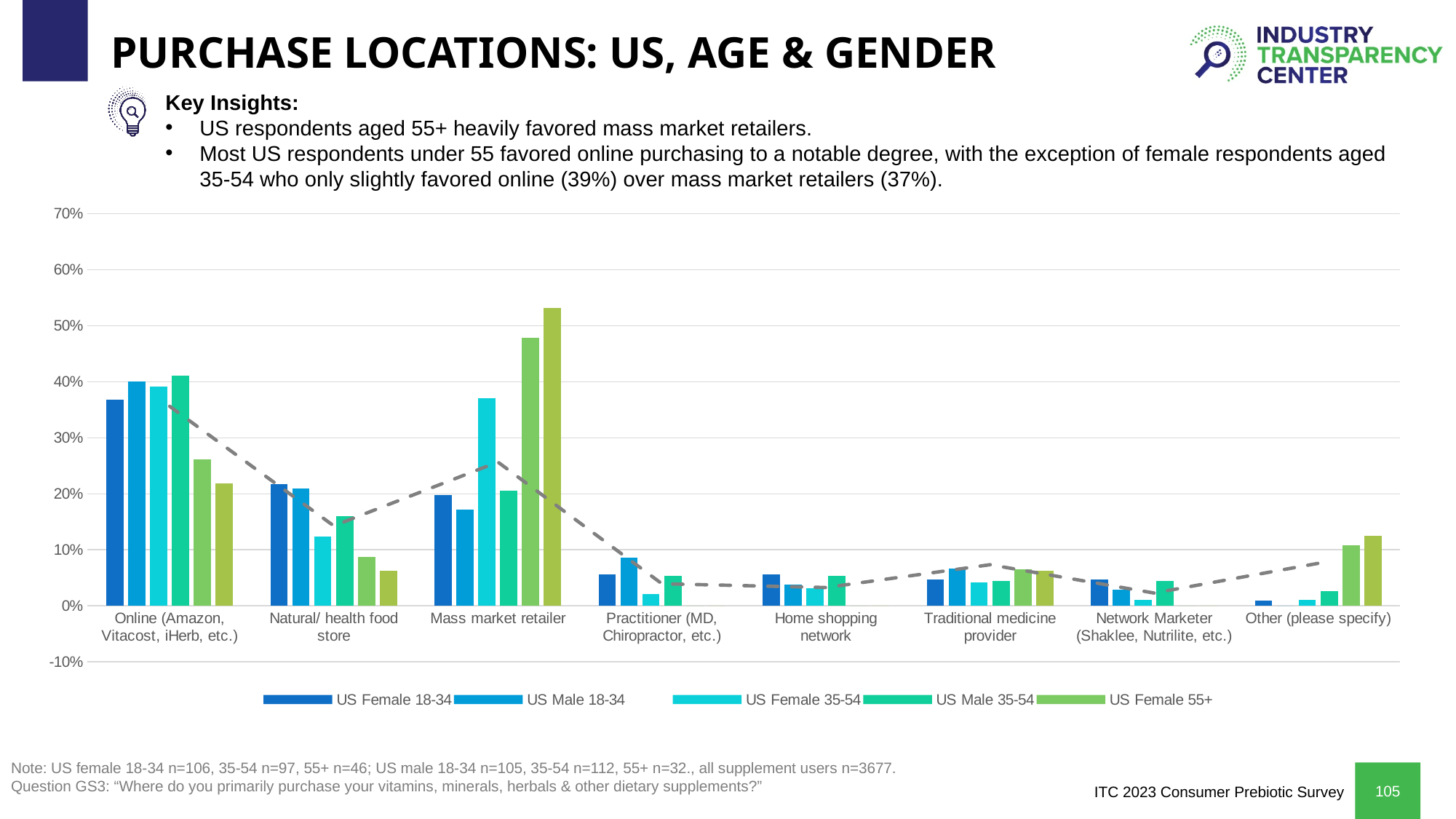
How many series does the legend list? 5 Which purchase location has the tallest bar for US Female 18-34? Online (Amazon, Vitacost, iHerb, etc.) Which purchase location has the tallest bar for US Female 55+? Mass market retailer Is the value for US Female 55+ at Mass market retailer greater or less than 40%? greater Is the value for US Female 18-34 at Online (Amazon, Vitacost, iHerb, etc.) greater or less than 30%? greater What is the title of the slide containing the chart? PURCHASE LOCATIONS: US, AGE & GENDER Is the value for US Male 18-34 at Mass market retailer greater or less than 20%? less According to the key insights, what percentage of US female respondents aged 35-54 favored online purchasing? 39% How many purchase location categories are shown on the x axis? 8 What kind of chart is shown on the slide? combination bar and line chart At Mass market retailer, which is larger: US Female 35-54 or US Male 35-54? US Female 35-54